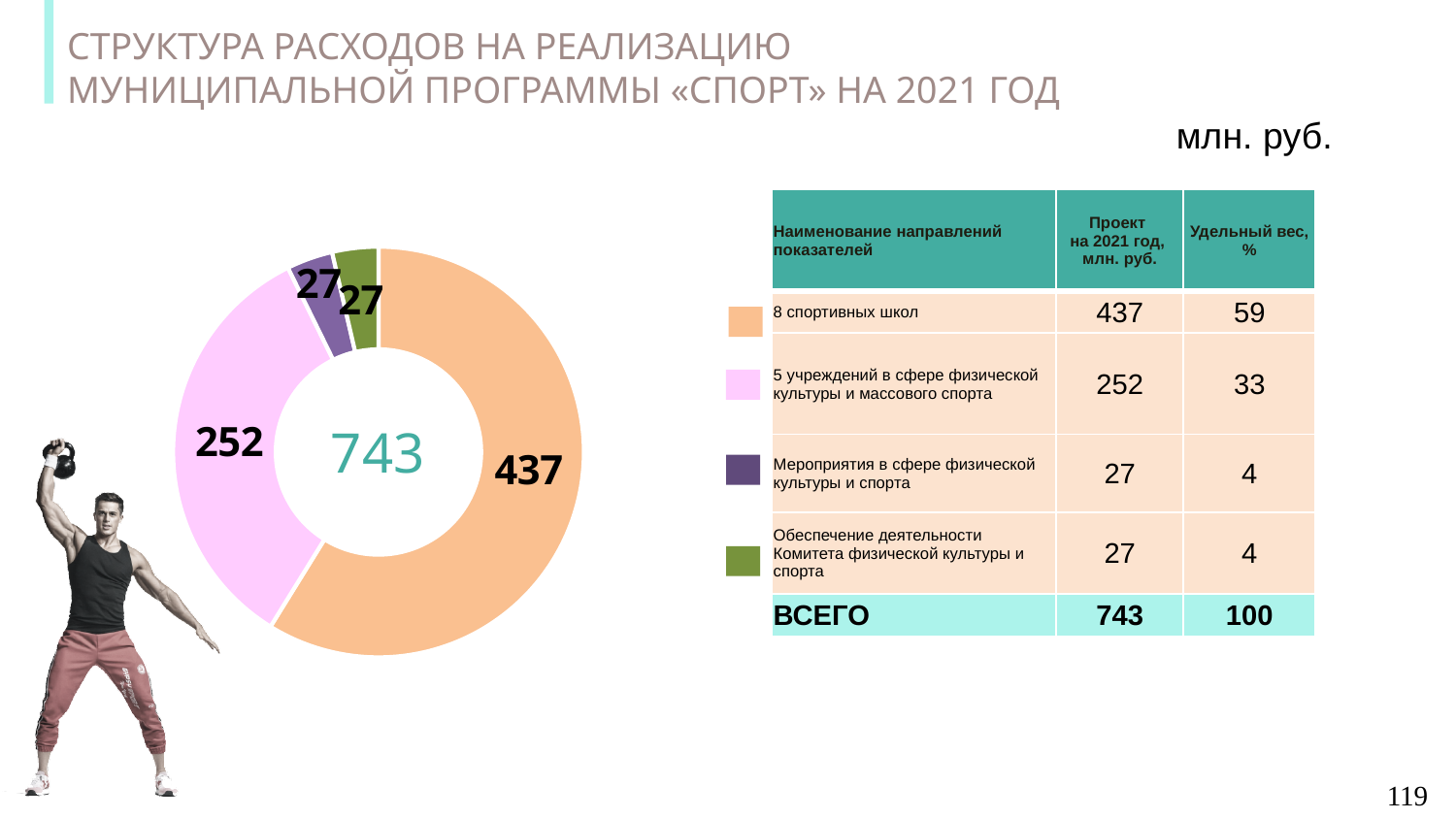
How many segments does the donut chart have? 4 What kind of chart is shown on the slide? Donut (pie) chart In what units are the values of the donut chart given? млн. руб. What is the value of the pink segment of the donut chart (5 учреждений в сфере физической культуры и массового спорта)? 252 What share of the total does the segment for 8 спортивных школ represent, according to the slide? 59% Which is larger in the donut chart: the segment for 8 спортивных школ or the segment for 5 учреждений в сфере физической культуры и массового спорта? 8 спортивных школ Which category has the highest value in the donut chart? 8 спортивных школ What is the value of the largest segment of the donut chart? 437 What value is shown in the centre of the donut chart? 743 What is the total of all segments in the donut chart? 743 What is the difference between the orange segment (437) and the pink segment (252) of the donut chart? 185 What is the value of the purple segment of the donut chart (Мероприятия в сфере физической культуры и спорта)? 27